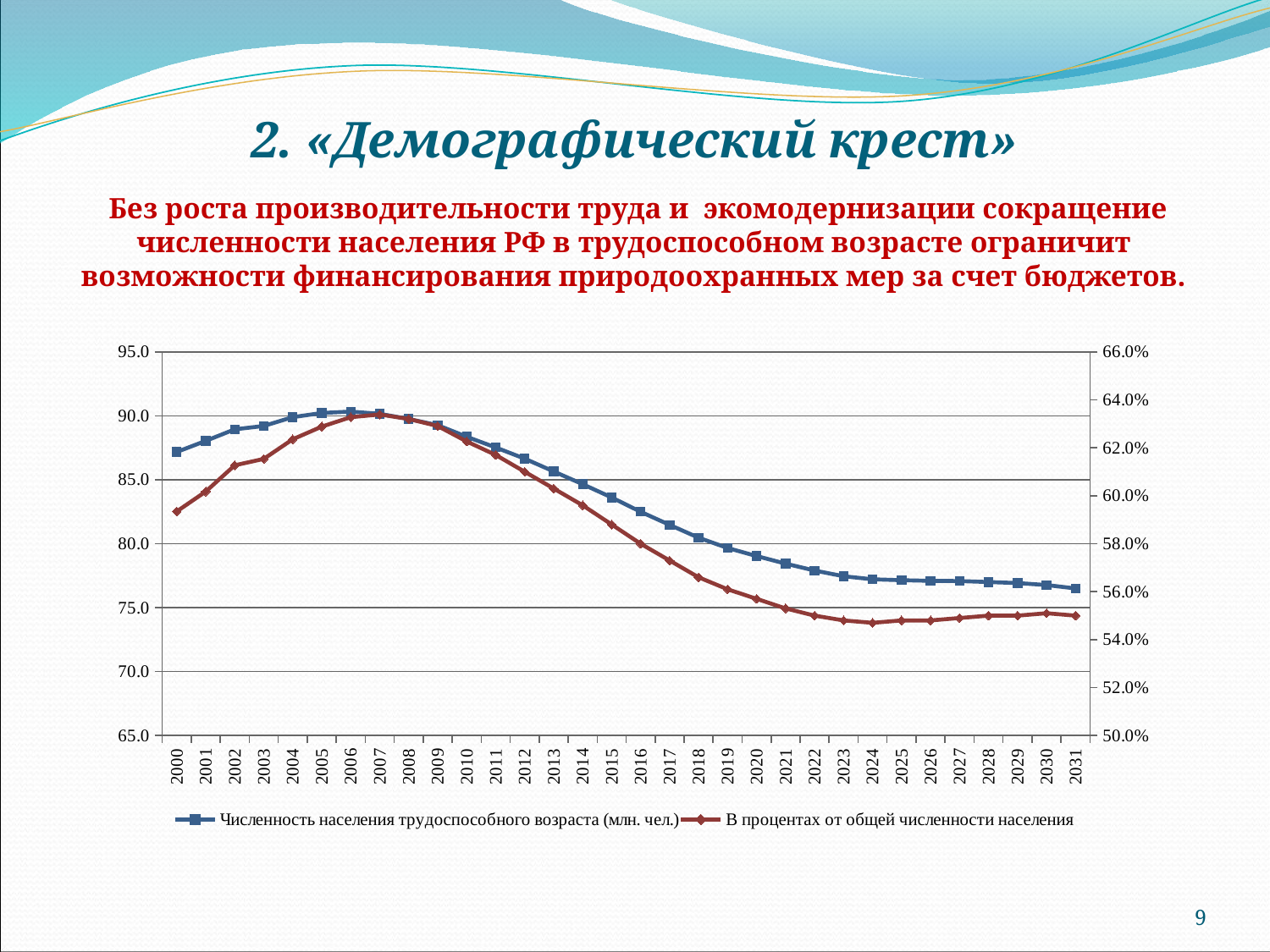
Does the 'Численность населения трудоспособного возраста (млн. чел.)' series rise or fall between 2010 and 2031? fall Is the value of 'Численность населения трудоспособного возраста (млн. чел.)' in 2031 greater or less than 75.0? greater What is the first year shown on the x axis of the chart? 2000 Is the value of 'В процентах от общей численности населения' in 2000 greater or less than 60.0%? less How many years are plotted along the x axis of the chart? 32 What kind of chart is shown on the slide? line chart How many series does the chart legend list? 2 Is the value of 'Численность населения трудоспособного возраста (млн. чел.)' in 2000 greater or less than 85.0? greater Which year has the lowest value for 'Численность населения трудоспособного возраста (млн. чел.)'? 2031 What is the last year shown on the x axis of the chart? 2031